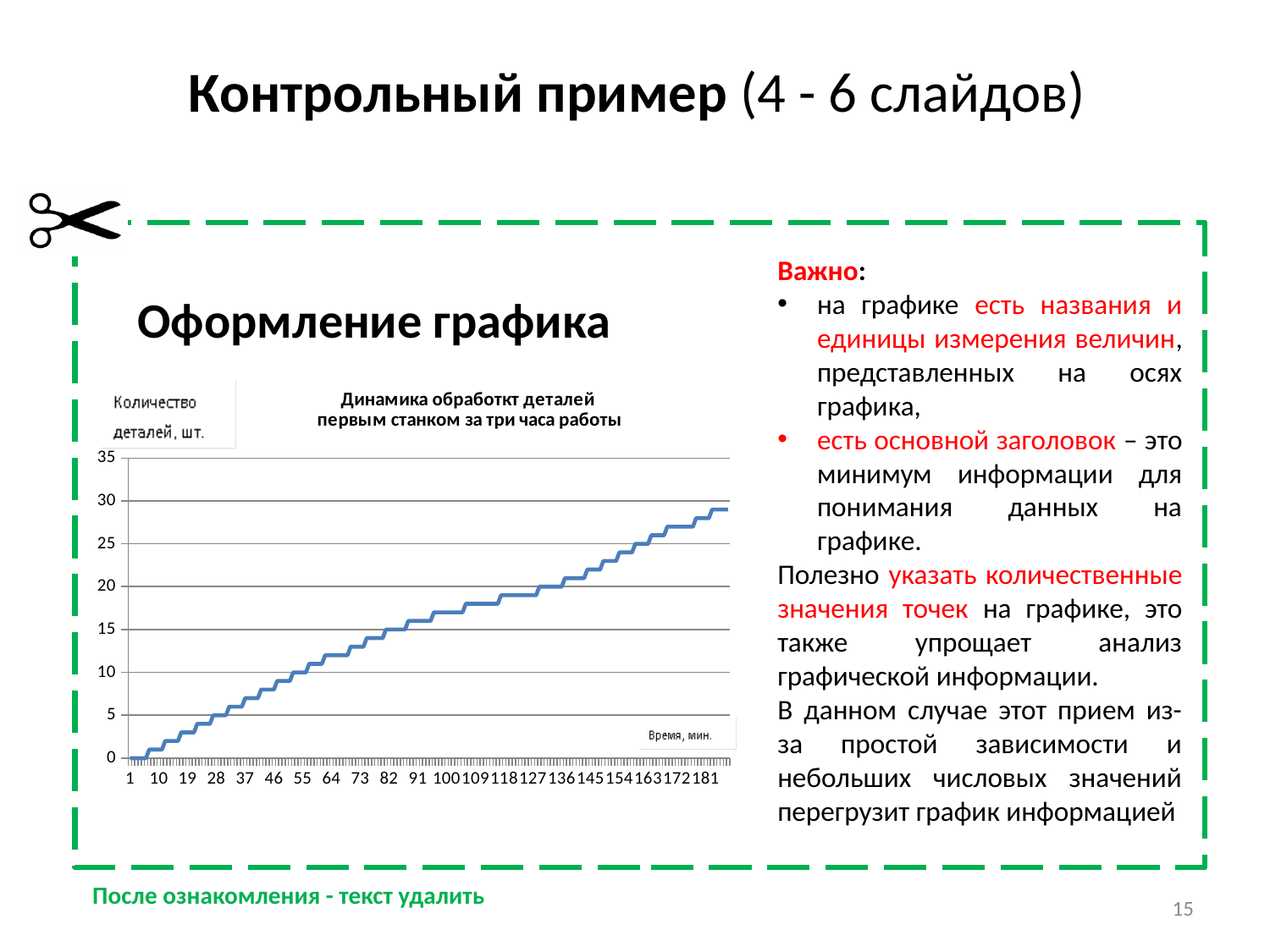
Is the value at time 100 greater or less than 15? greater Is the value at time 19 greater or less than 5? less Which is larger: the value at time 64 or the value at time 154? 154 Is the value at time 181 greater or less than 25? greater Do the values on the chart rise or fall as time increases along the x axis? rise What is the title of the chart? Динамика обработкт деталей первым станком за три часа работы What kind of chart is shown on the slide? line chart What is the label of the vertical axis of the chart? Количество деталей, шт.